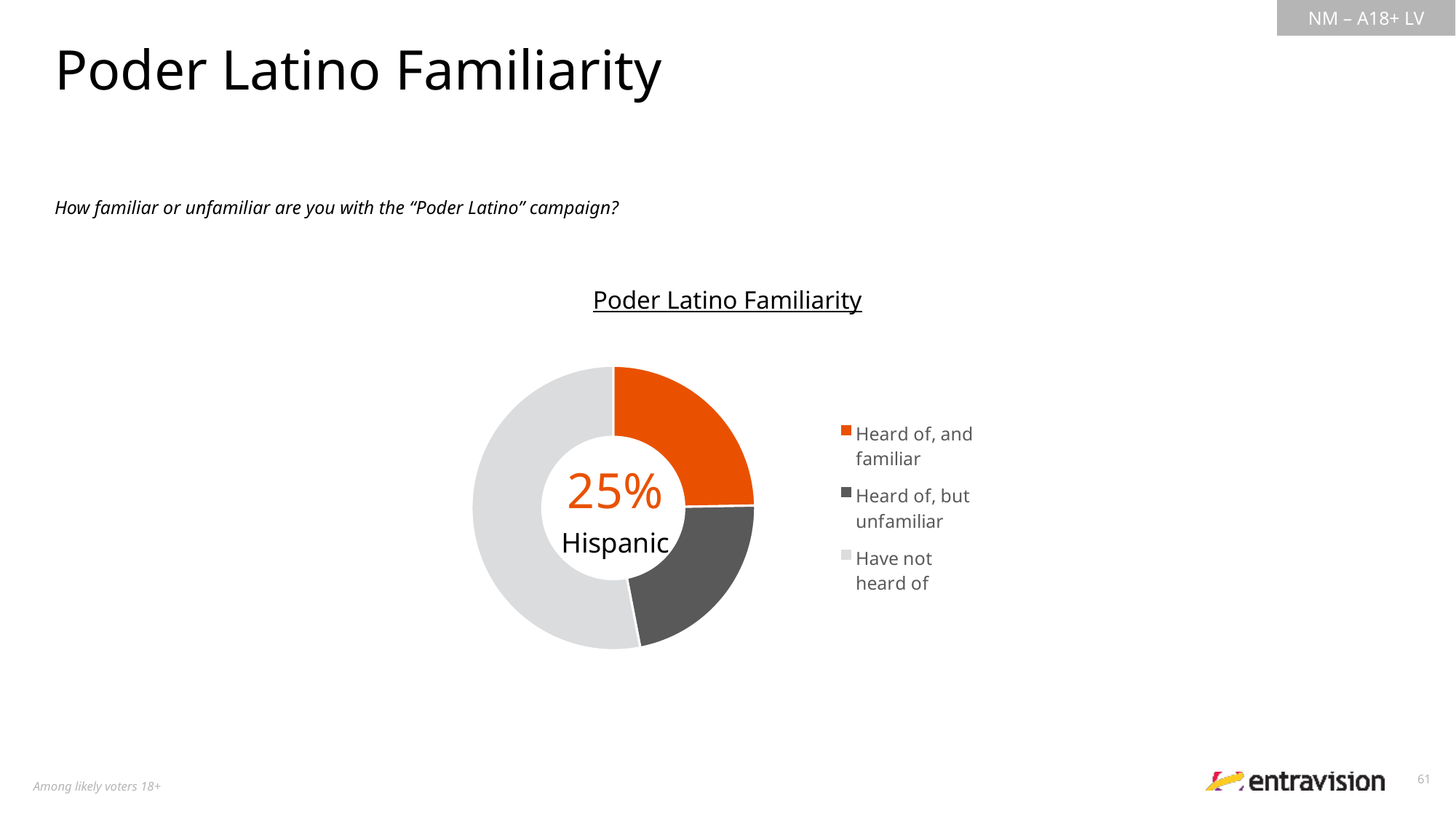
What percentage of Hispanic likely voters have heard of and are familiar with the Poder Latino campaign? 25% What is the title of the chart on the slide? Poder Latino Familiarity Which response category has the largest share of the Poder Latino Familiarity chart? Have not heard of What colour represents 'Heard of, and familiar' in the chart? Orange What share of the pie does the 'Heard of, and familiar' slice represent? 25% What kind of chart is used to show Poder Latino Familiarity? Pie (donut) chart Which is larger: the share for 'Have not heard of' or the share for 'Heard of, and familiar'? Have not heard of How many slices does the Poder Latino Familiarity chart have? 3 How many entries does the legend of the Poder Latino Familiarity chart list? 3